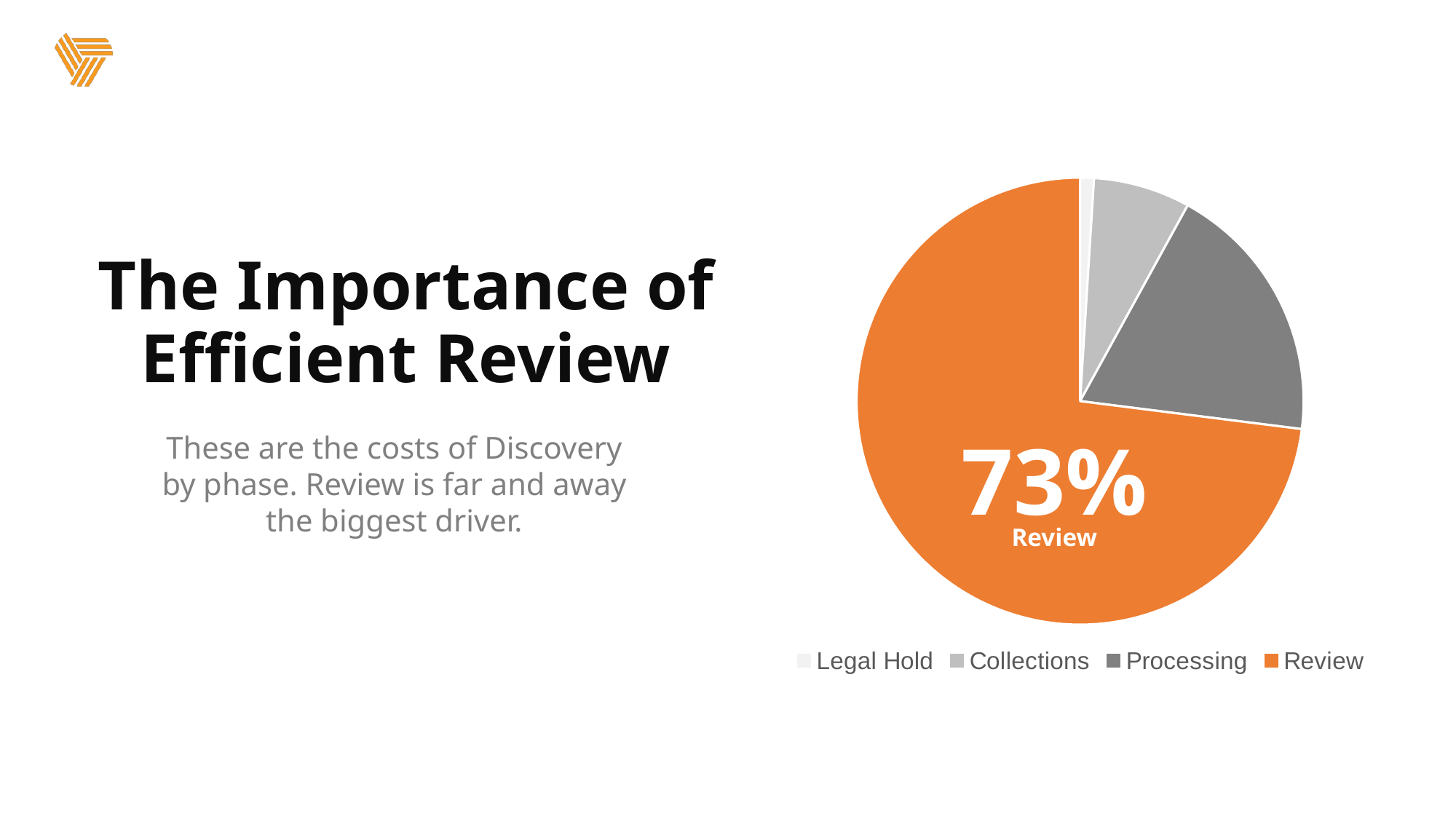
What colour is the Review slice? orange Which slice is larger, Collections or Legal Hold? Collections Which category is listed first in the legend? Legal Hold Which category has the largest slice of the pie? Review Which category has the smallest slice of the pie? Legal Hold What kind of chart is shown on the slide? pie chart How many categories does the pie chart show? 4 Which slice is larger, Processing or Collections? Processing How many entries does the legend list? 4 Which slice is larger, Review or Processing? Review What share of the pie does Review account for? 73%